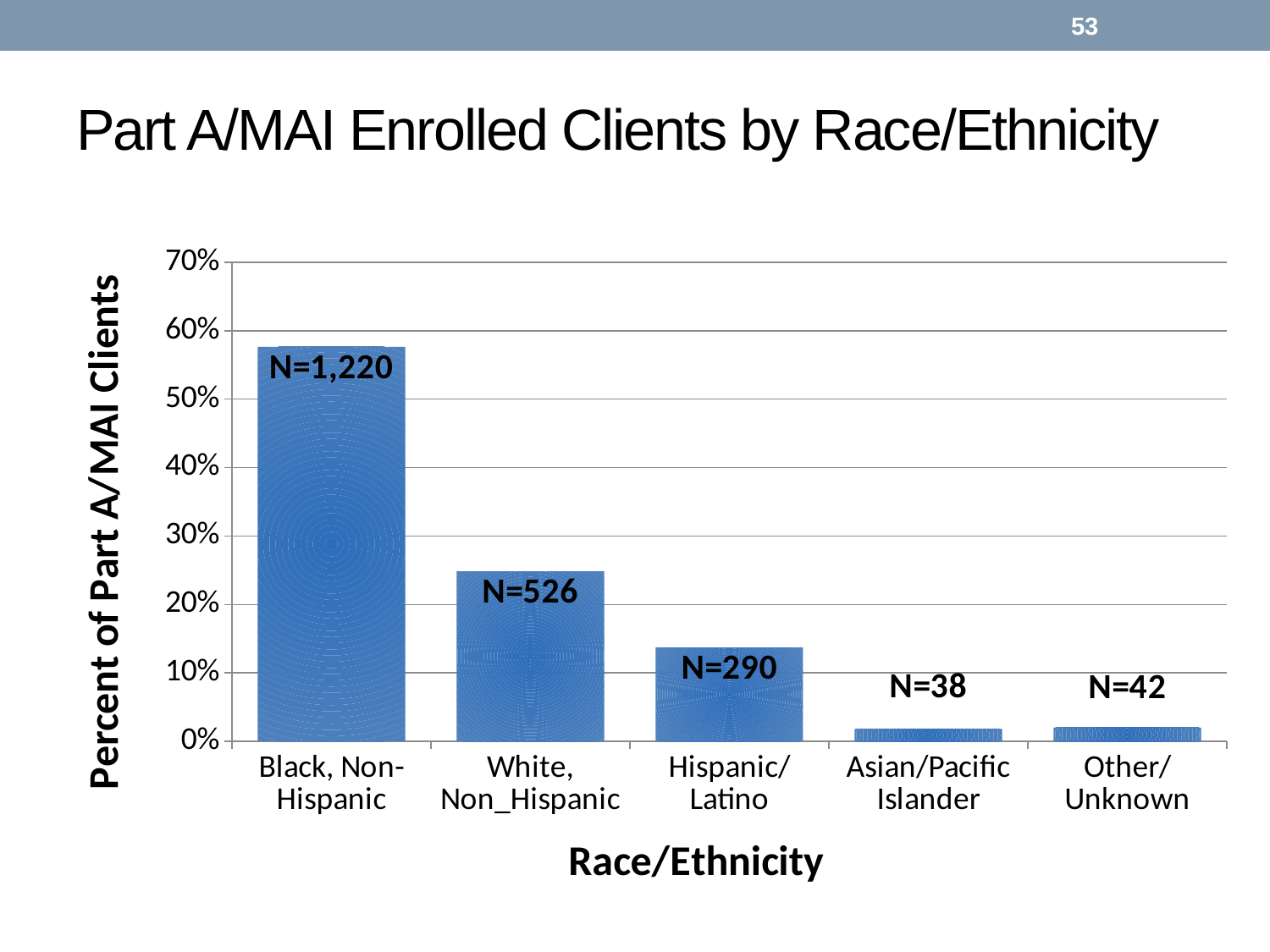
Is the percent of Part A/MAI clients for White, Non_Hispanic greater or less than 30%? less What is the N value shown for Hispanic/Latino clients? N=290 Which race/ethnicity category has the highest percent of Part A/MAI clients? Black, Non-Hispanic How many race/ethnicity categories are shown on the chart? 5 Which has a larger N value, Hispanic/Latino or White, Non_Hispanic? White, Non_Hispanic What is the N value shown for Asian/Pacific Islander clients? N=38 What is the N value shown for White, Non_Hispanic clients? N=526 Which race/ethnicity category has the smallest N value? Asian/Pacific Islander Is the percent of Part A/MAI clients for Black, Non-Hispanic greater or less than 50%? greater What is the difference between the N values for Black, Non-Hispanic and White, Non_Hispanic clients? 694 What is the N value shown for Black, Non-Hispanic clients? N=1,220 What kind of chart is shown on the slide? bar chart